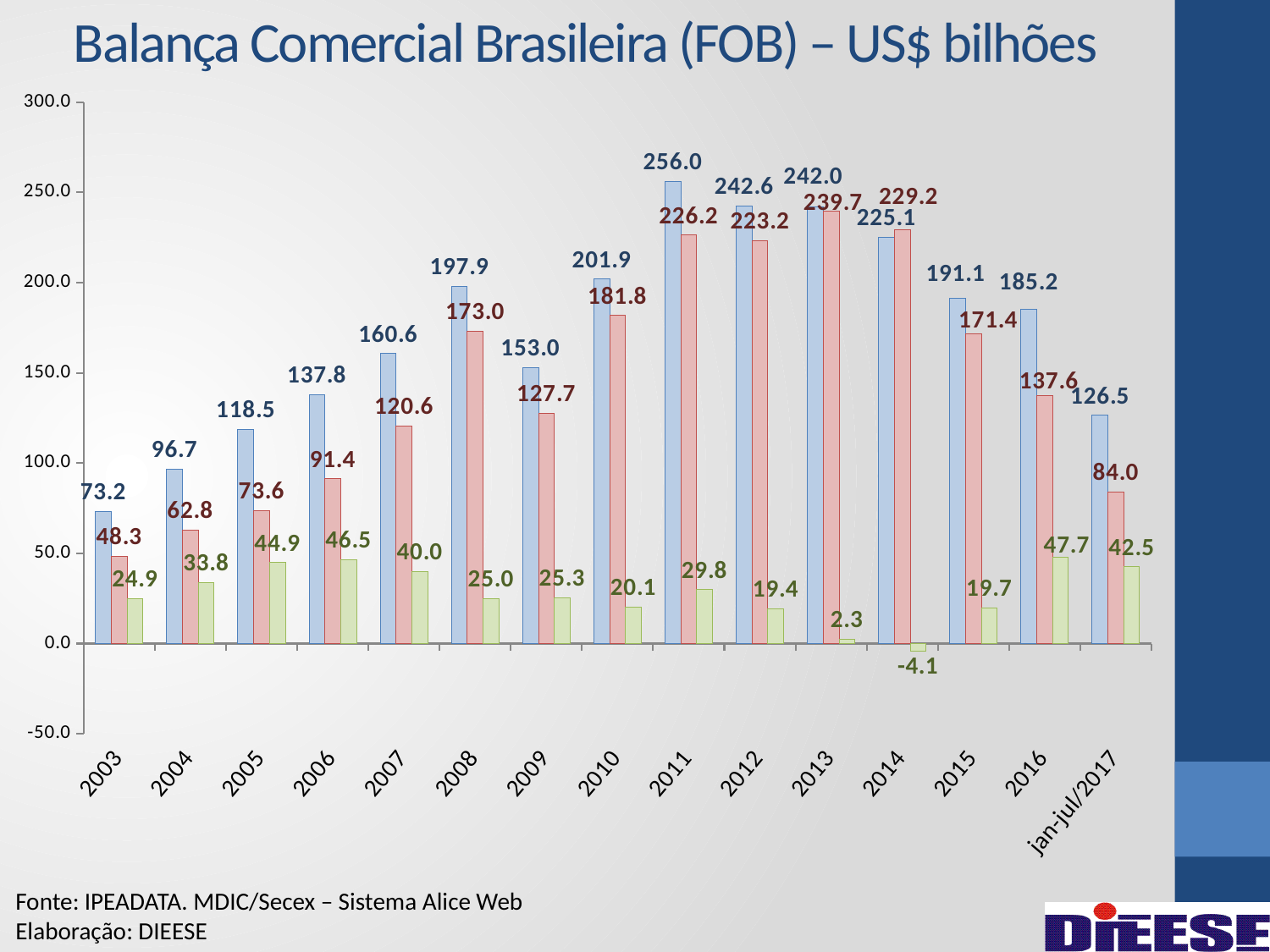
Which is larger in 2008, the blue bar or the red bar? The blue bar What is the value of the green bar for 2014? -4.1 Do the blue bars rise or fall from 2011 to 2016? Fall In which year is the green bar at its highest value? 2016 What is the value of the red bar for 2008? 173.0 How many periods are shown on the x axis? 15 What kind of chart is shown on the slide? Bar chart In which year is the green bar at its lowest value? 2014 What is the value of the blue bar for 2011? 256.0 Is the value of the blue bar for 2007 greater or less than 150.0? greater What is the difference between the blue bar and the red bar in 2011? 29.8 In which year does the blue bar reach its highest value? 2011